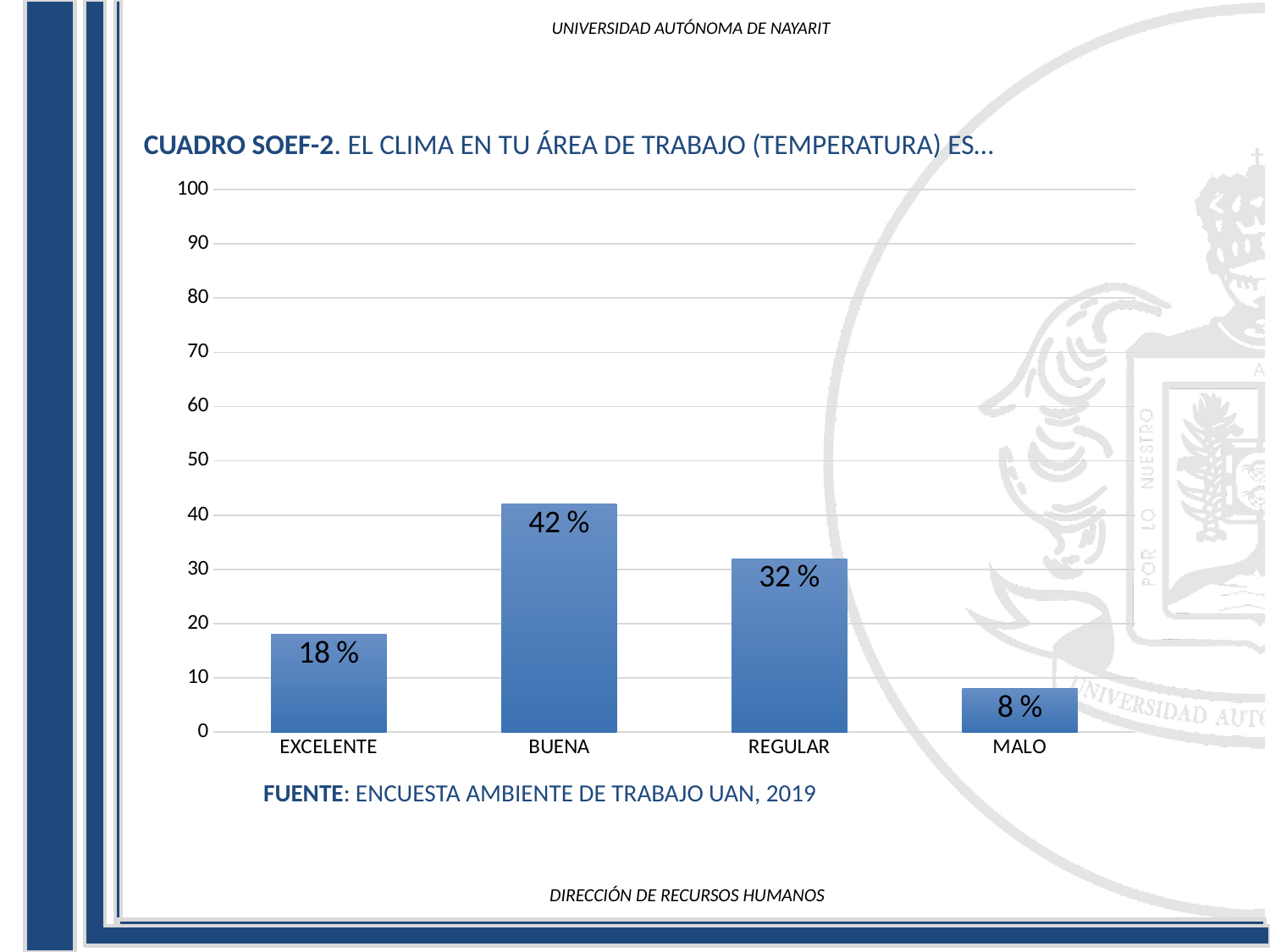
What is the value for REGULAR? 32 % What is the value for EXCELENTE? 18 % What is the value for MALO? 8 % What kind of chart is shown on the slide? bar chart How many categories are shown on the x axis? 4 Which category has the highest value? BUENA What is the difference between the values for BUENA and REGULAR? 10 % Is the value for MALO greater or less than 10? less What is the value for BUENA? 42 % Which category has the lowest value? MALO What source is cited below the chart? ENCUESTA AMBIENTE DE TRABAJO UAN, 2019 Which is larger, the value for EXCELENTE or the value for REGULAR? REGULAR